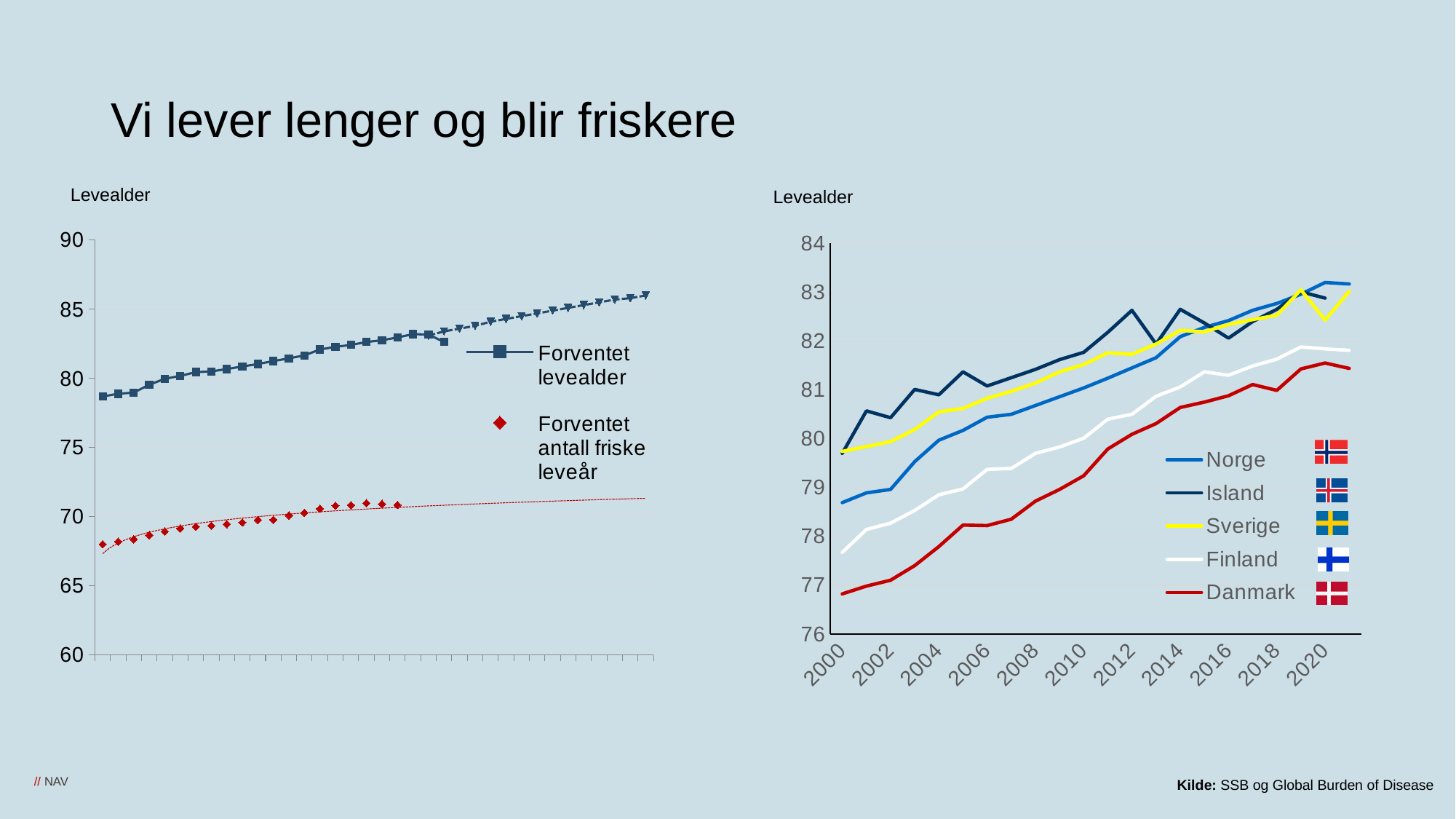
In the right-hand chart, is the value for Danmark in 2000 greater or less than 77? less In the right-hand chart, is the value for Finland in 2000 greater or less than 77? greater In the right-hand chart, do the values for Danmark rise or fall from 2000 to 2020? rise In the right-hand chart, which is larger in 2010, the value for Norge or the value for Danmark? Norge How many series does the legend of the right-hand chart list? 5 In the left-hand chart, which series has the higher values, Forventet levealder or Forventet antall friske leveår? Forventet levealder What kind of chart is the right-hand chart with the country lines? line chart In the right-hand chart, which country has the lowest life expectancy in 2000? Danmark In the left-hand chart, is the first value of Forventet levealder greater or less than 80? less How many series does the legend of the left-hand chart list? 2